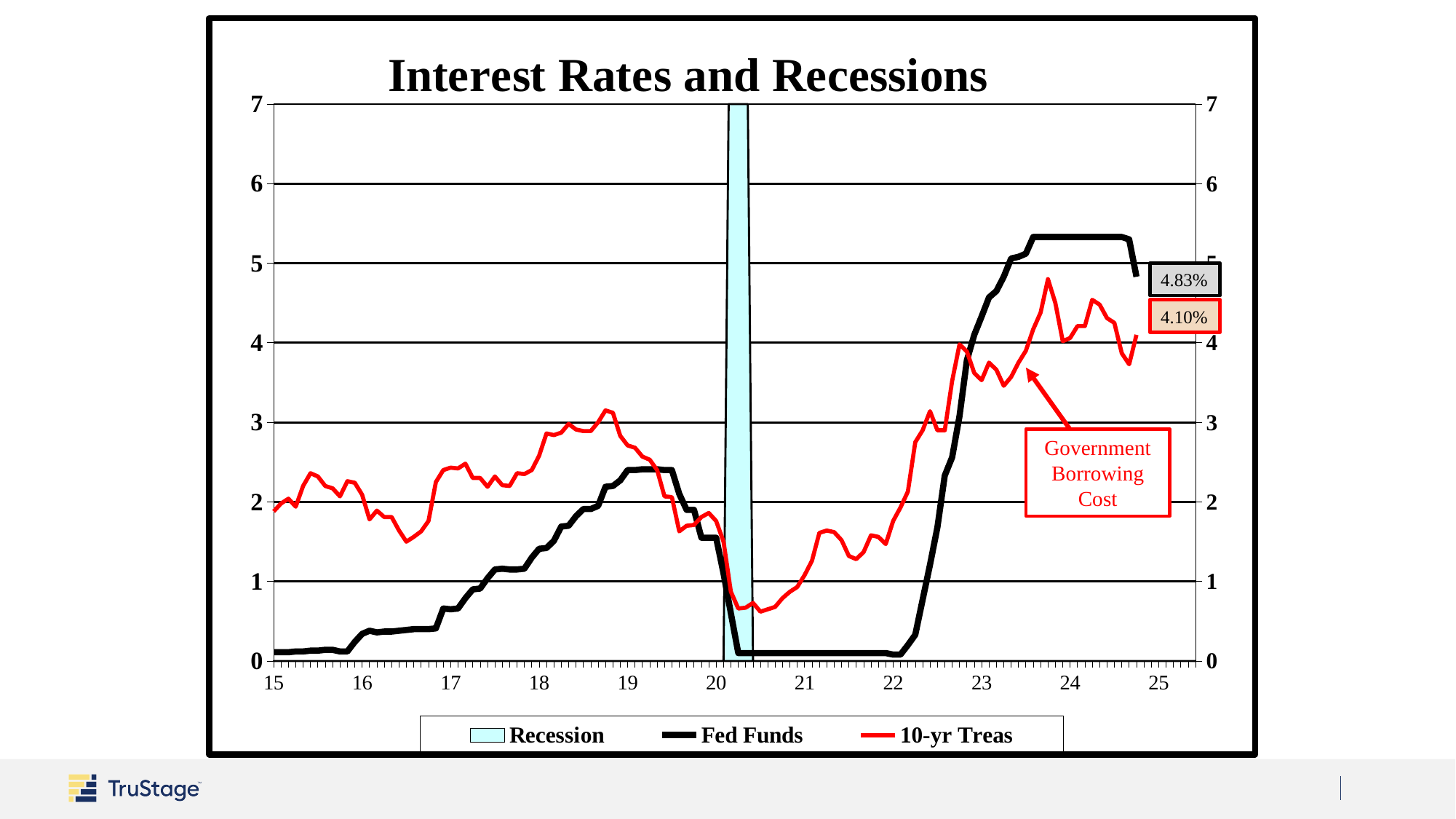
Which series does the 'Government Borrowing Cost' annotation point to? 10-yr Treas What is the difference between the labelled Fed Funds value (4.83%) and the labelled 10-yr Treas value (4.10%)? 0.73 percentage points Which series has the higher labelled latest value, Fed Funds or 10-yr Treas? Fed Funds What is the latest labelled value for the 10-yr Treas series? 4.10% What is the title of the chart? Interest Rates and Recessions Is the 10-yr Treas value around 16 greater or less than 3? less How many entries does the chart's legend list? 3 Is the Fed Funds value during 2021 greater or less than 1? less What is the latest labelled value for the Fed Funds series? 4.83% Does the Fed Funds series rise or fall between 22 and 23 on the x axis? rise What kind of chart is shown on the slide? line chart Is the Fed Funds value at its plateau between 23 and 24 greater or less than 5? greater